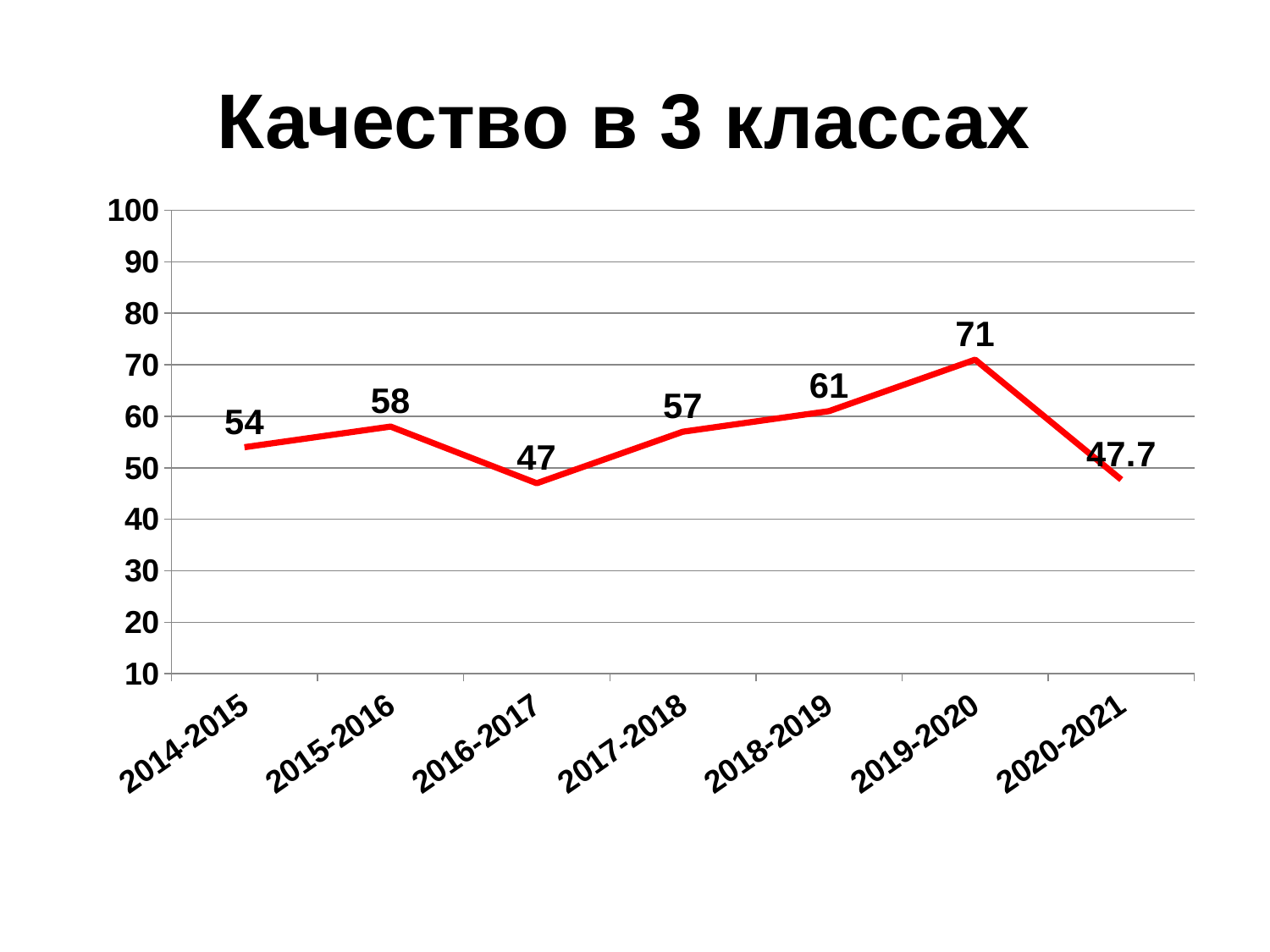
What is the value for 2018-2019? 61 Which is larger, the value for 2017-2018 or the value for 2015-2016? 2015-2016 What is the difference between the values for 2015-2016 and 2016-2017? 11 What kind of chart is shown on the slide? line chart How many years are plotted on the chart? 7 What is the difference between the values for 2019-2020 and 2020-2021? 23.3 What is the value for 2014-2015? 54 What is the title of the chart? Качество в 3 классах Which year has the highest value? 2019-2020 Which year has the lowest value? 2016-2017 What is the value for 2020-2021? 47.7 Is the value for 2019-2020 greater or less than 70? greater